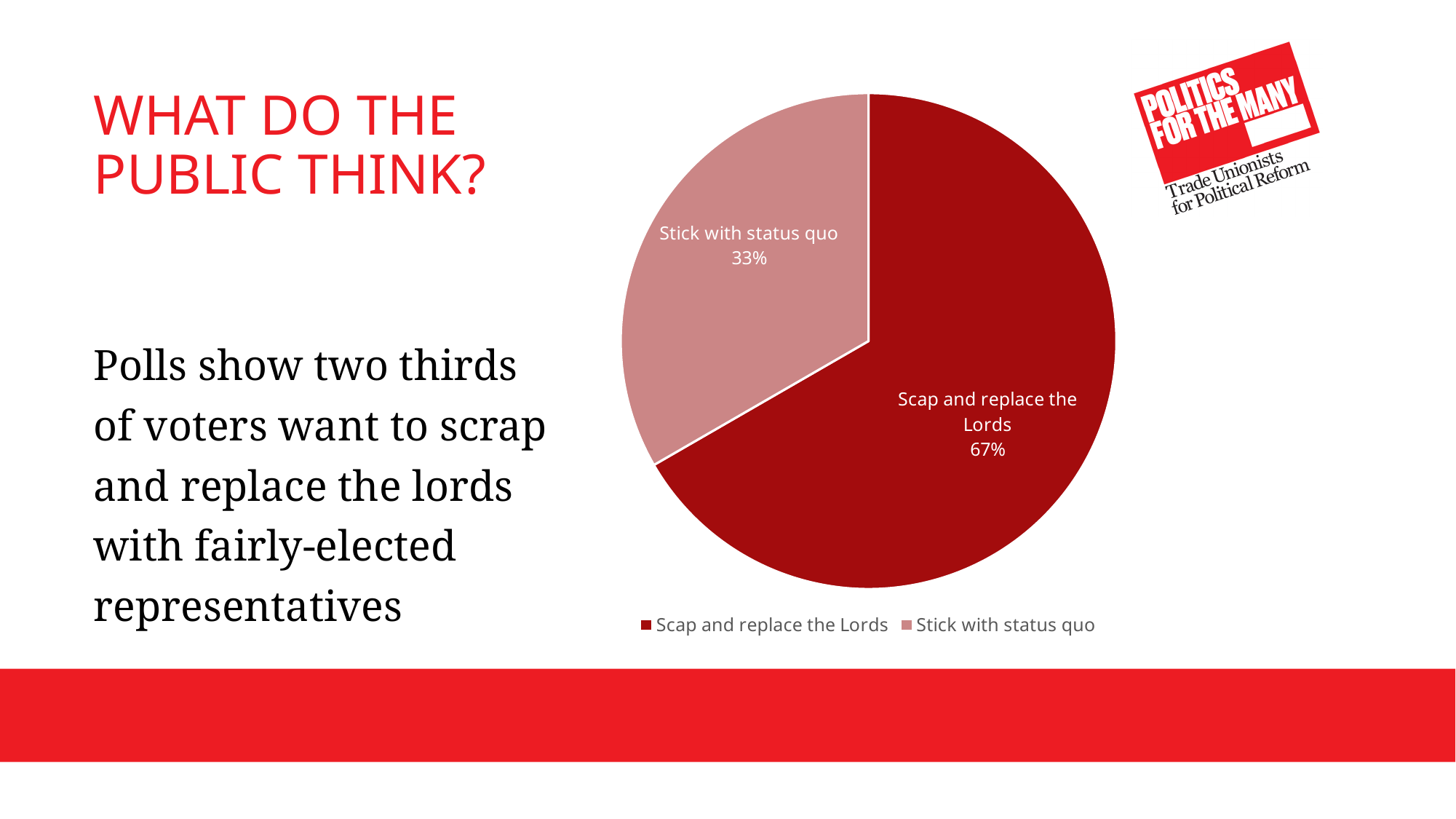
What is the difference in percentage points between the "Scap and replace the Lords" slice and the "Stick with status quo" slice? 34 What percentage of the pie is labelled "Stick with status quo"? 33% What share of the pie does the "Stick with status quo" slice represent? 33% What percentage of the pie is labelled "Scap and replace the Lords"? 67% Which slice of the pie chart is the smallest? Stick with status quo What kind of chart is shown on the slide? Pie chart How many slices does the pie chart have? 2 Which legend entry is shown in the lighter pink colour? Stick with status quo Which slice of the pie chart is the largest? Scap and replace the Lords Which is larger: the "Scap and replace the Lords" slice or the "Stick with status quo" slice? Scap and replace the Lords Where is the legend positioned relative to the pie chart? Below the chart How many entries does the legend list? 2